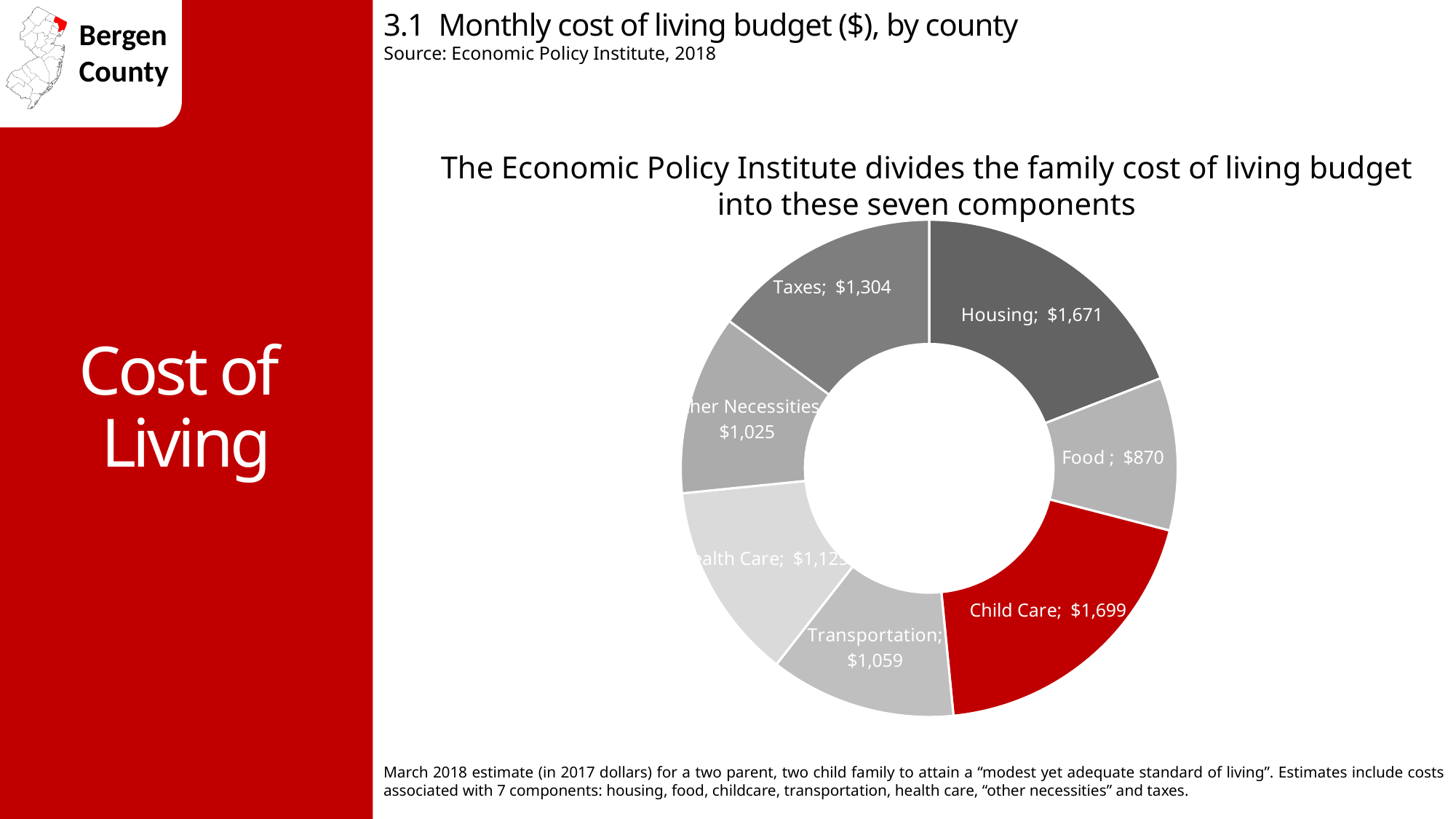
What is the monthly cost for Child Care shown on the chart? $1,699 What is the difference between the Taxes cost and the Transportation cost? $245 How many components are shown in the chart? 7 What kind of chart is shown on the slide? Doughnut chart What is the monthly cost for Housing shown on the chart? $1,671 What is the monthly cost for Taxes shown on the chart? $1,304 What is the monthly cost for Transportation shown on the chart? $1,059 Which component has the highest monthly cost? Child Care What is the difference between the Housing cost and the Food cost? $801 What is the monthly cost for Food shown on the chart? $870 Which component has the lowest monthly cost? Food Which is larger, the cost for Taxes or the cost for Other Necessities? Taxes